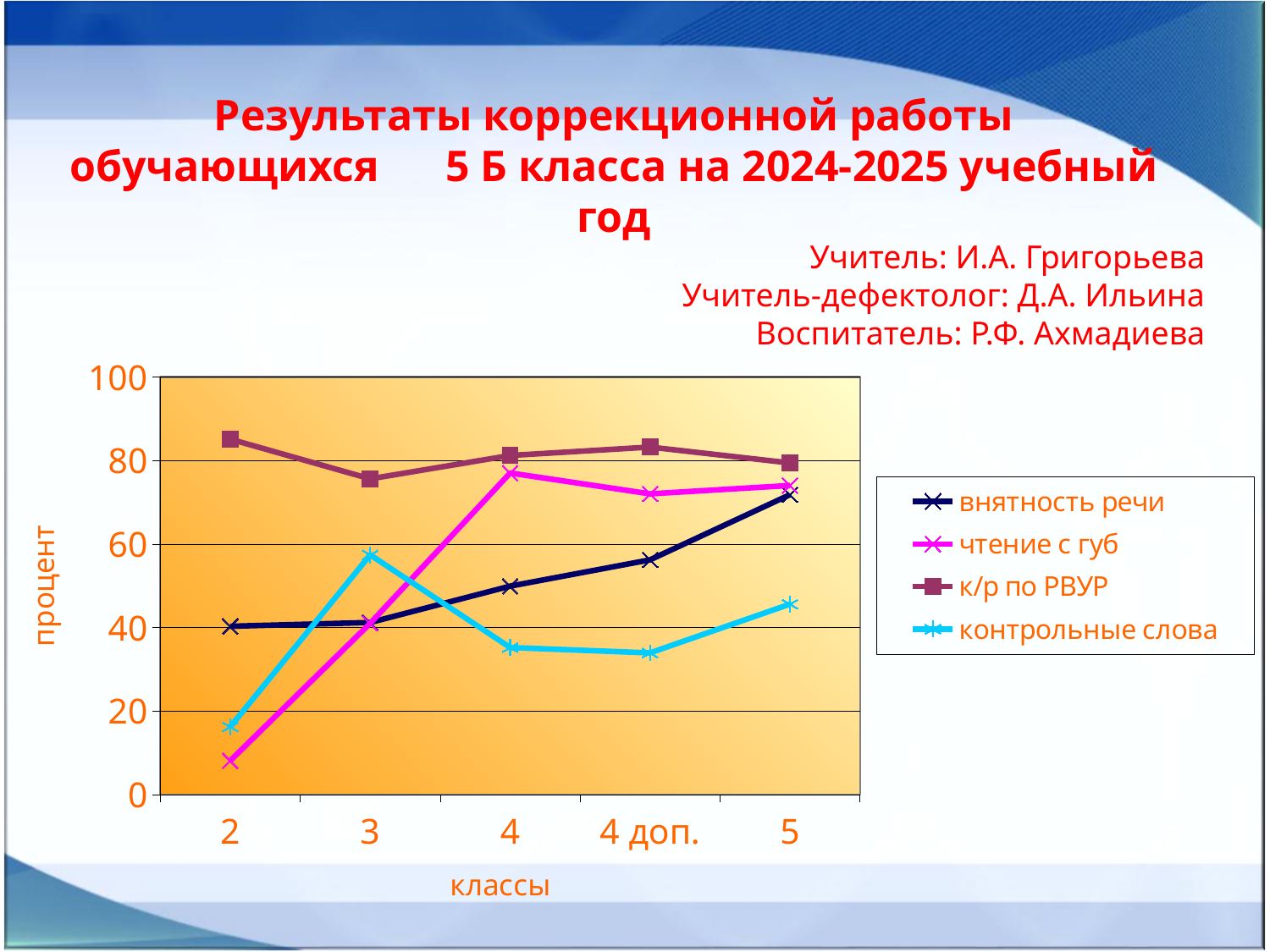
How many categories are shown on the x axis? 5 How many series does the legend list? 4 Is the value for контрольные слова in class 3 greater or less than 40? greater Is the value for к/р по РВУР in class 2 greater or less than 80? greater Which series has the lowest value in class 2? чтение с губ In class 5, which is larger: внятность речи or контрольные слова? внятность речи Does the внятность речи series rise or fall from class 2 to class 5? rises What kind of chart is shown on the slide? line chart For внятность речи, in which class is the value highest? 5 Which series has the highest value in class 2? к/р по РВУР What is the title of the x axis? классы Is the value for чтение с губ in class 2 greater or less than 20? less